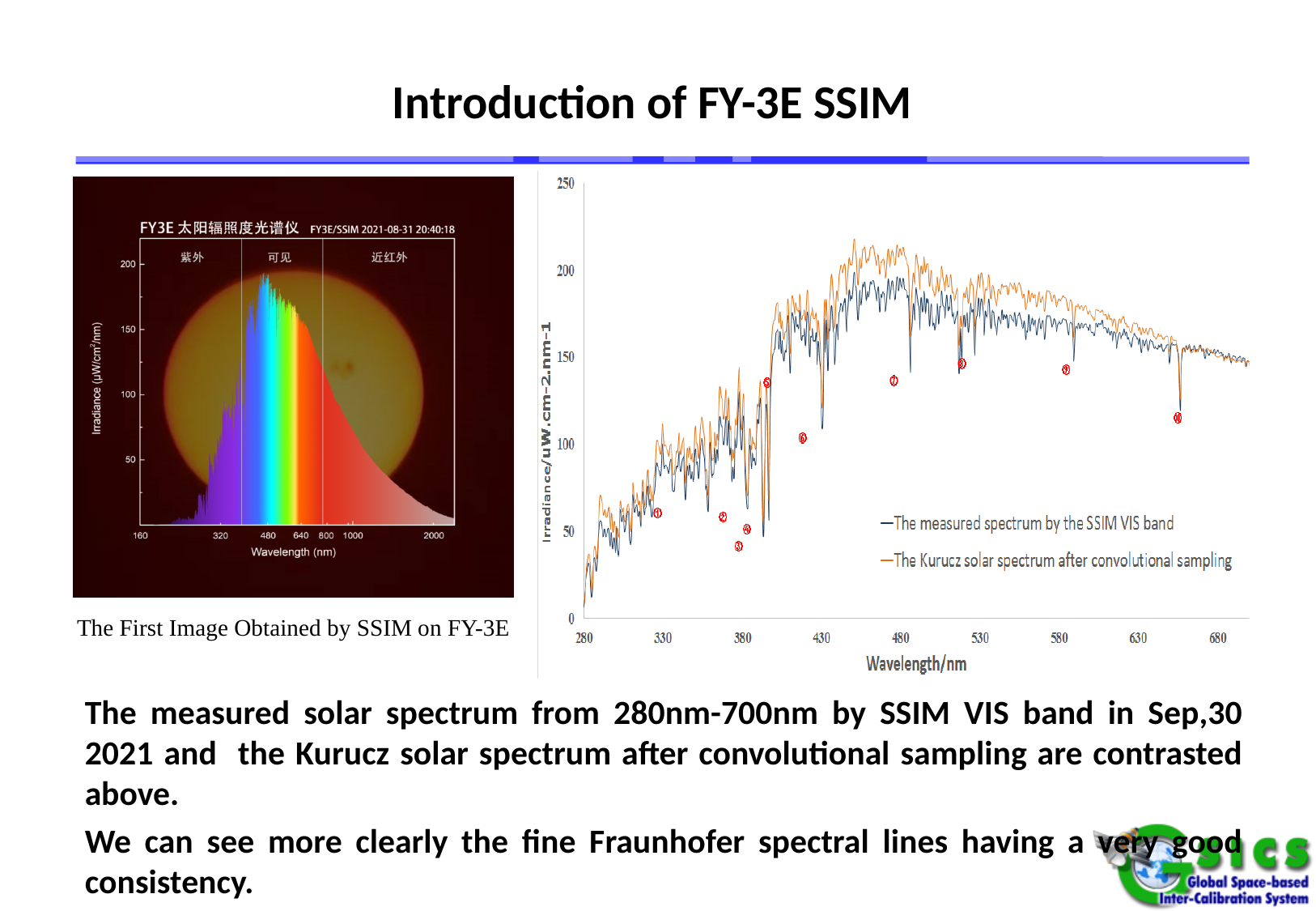
In the right-hand chart, which series has the higher value at around 480 nm, the measured SSIM spectrum or the Kurucz solar spectrum? The Kurucz solar spectrum after convolutional sampling What kind of chart is the right-hand chart comparing the measured spectrum and the Kurucz solar spectrum? line chart In the right-hand chart, do the irradiance values rise or fall as wavelength increases from 280 nm to 430 nm? rise In the right-hand chart, what is the label of the x axis? Wavelength/nm In the right-hand chart, which series is drawn in orange? The Kurucz solar spectrum after convolutional sampling In the left-hand chart (the first image obtained by SSIM on FY-3E), what is the highest wavelength tick shown on the x axis? 2000 In the right-hand chart, is the peak value of the Kurucz solar spectrum (around 450 nm) greater or less than 200? greater In the right-hand chart, what is the lowest wavelength tick shown on the x axis? 280 In the right-hand chart, do the irradiance values rise or fall as wavelength increases from 480 nm to 680 nm? fall How many series does the legend of the right-hand chart list? 2 In the right-hand chart, is the value of the measured SSIM spectrum at 280 nm greater or less than 50? less In the right-hand chart, is the value of the measured SSIM spectrum at 330 nm greater or less than 100? less